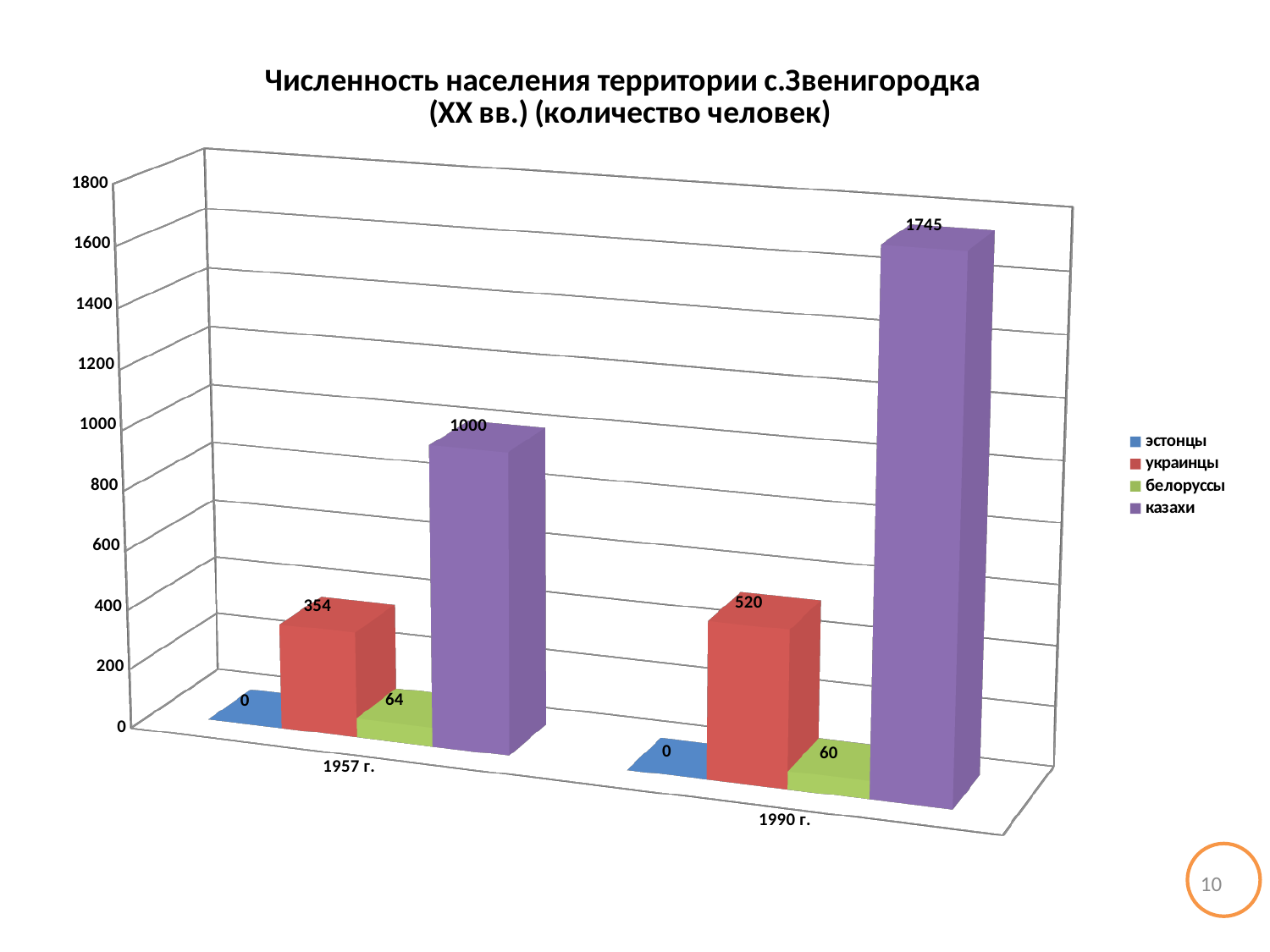
What is the value for украинцы in 1957 г.? 354 What is the difference between the казахи values for 1990 г. and 1957 г.? 745 What is the value for казахи in 1990 г.? 1745 What kind of chart is shown on the slide? bar chart How many series does the legend list? 4 What is the value for белоруссы in 1990 г.? 60 How many year categories are shown on the x axis? 2 Which group has the lowest value in 1957 г.? эстонцы Which group has the highest value in 1990 г.? казахи Which is larger: белоруссы in 1957 г. or белоруссы in 1990 г.? белоруссы in 1957 г. What is the difference between the украинцы values for 1990 г. and 1957 г.? 166 What is the value for эстонцы in 1957 г.? 0